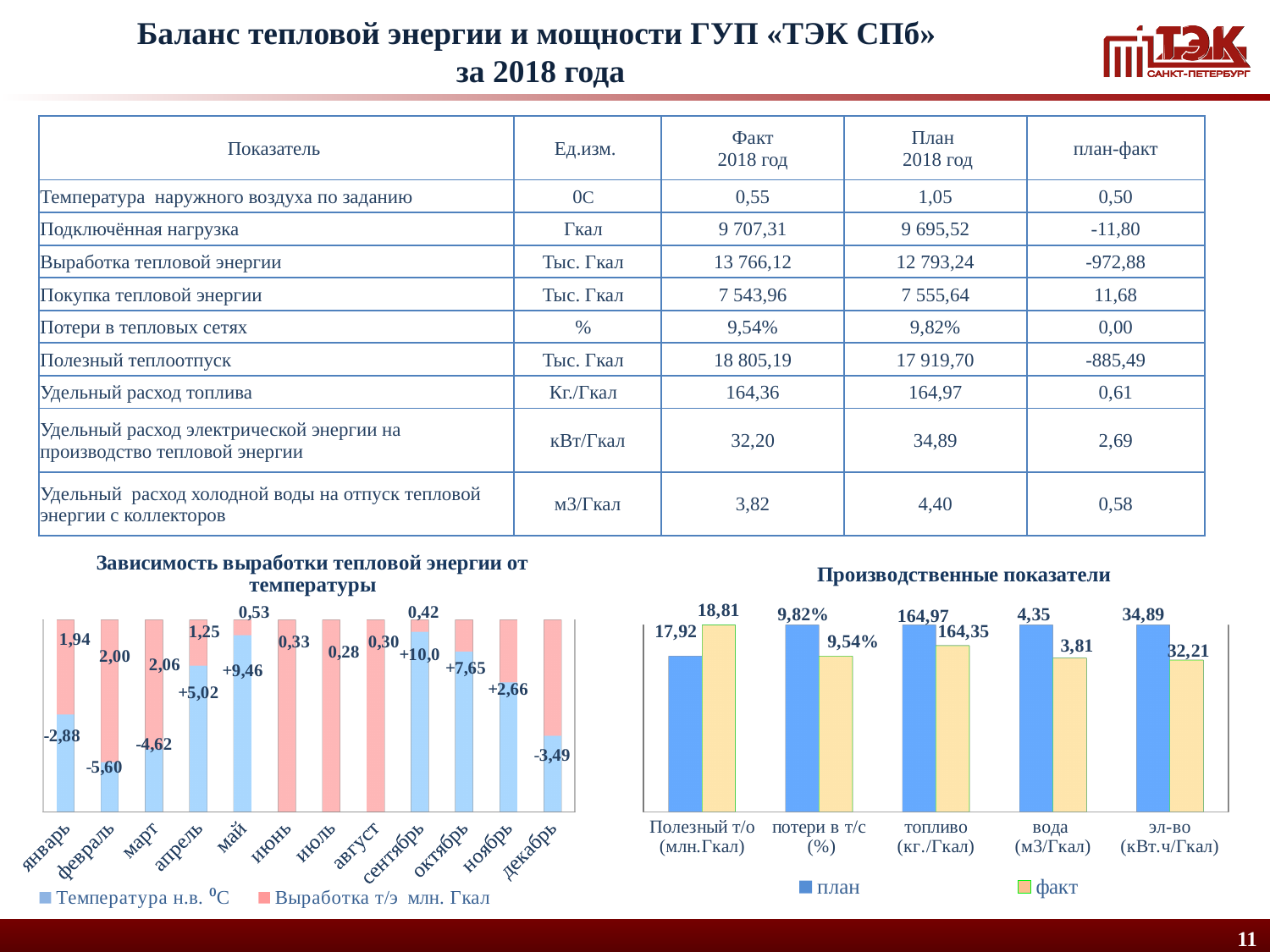
In the chart 'Зависимость выработки тепловой энергии от температуры', how many months are shown on the x axis? 12 In the chart 'Зависимость выработки тепловой энергии от температуры', what is the Выработка т/э value for март? 2,06 In the chart 'Производственные показатели', what is the план value for Полезный т/о (млн.Гкал)? 17,92 In the chart 'Производственные показатели', how many categories are shown on the x axis? 5 In the chart 'Зависимость выработки тепловой энергии от температуры', which series does the pink/red colour represent? Выработка т/э млн. Гкал What kind of chart is 'Производственные показатели'? bar chart In the chart 'Производственные показатели', which is larger for топливо (кг./Гкал): план or факт? план In the chart 'Производственные показатели', what is the факт value for потери в т/с (%)? 9,54% In the chart 'Производственные показатели', how many series does the legend list? 2 In the chart 'Производственные показатели', what is the факт value for эл-во (кВт.ч/Гкал)? 32,21 In the chart 'Производственные показатели', what is the difference between the план and факт values for вода (м3/Гкал)? 0,54 In the chart 'Зависимость выработки тепловой энергии от температуры', what is the Температура н.в. value for февраль? -5,60